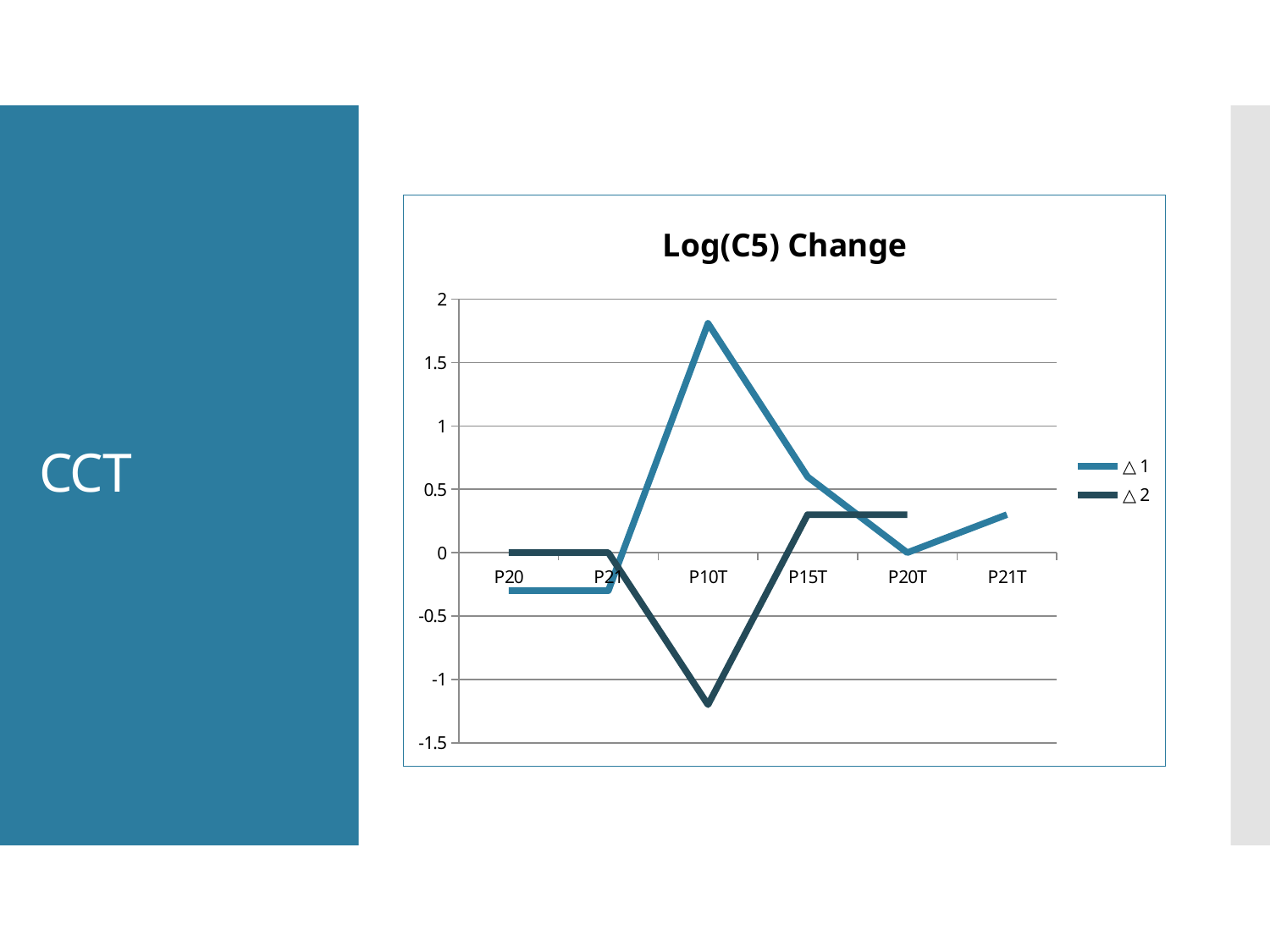
Is the value of △ 1 at P10T greater or less than 1.5? greater How many series does the legend list? 2 Which series has the larger value at P10T, △ 1 or △ 2? △ 1 Does the △ 1 series rise or fall from P10T to P20T? fall At which category does the △ 1 series reach its highest value? P10T What kind of chart is shown on the slide? line chart How many categories are shown on the x axis? 6 What is the title of the chart? Log(C5) Change Is the value of △ 1 at P20 greater or less than 0? less Is the value of △ 2 at P10T greater or less than -1? less Which series has the larger value at P20, △ 1 or △ 2? △ 2 At which category does the △ 2 series reach its lowest value? P10T